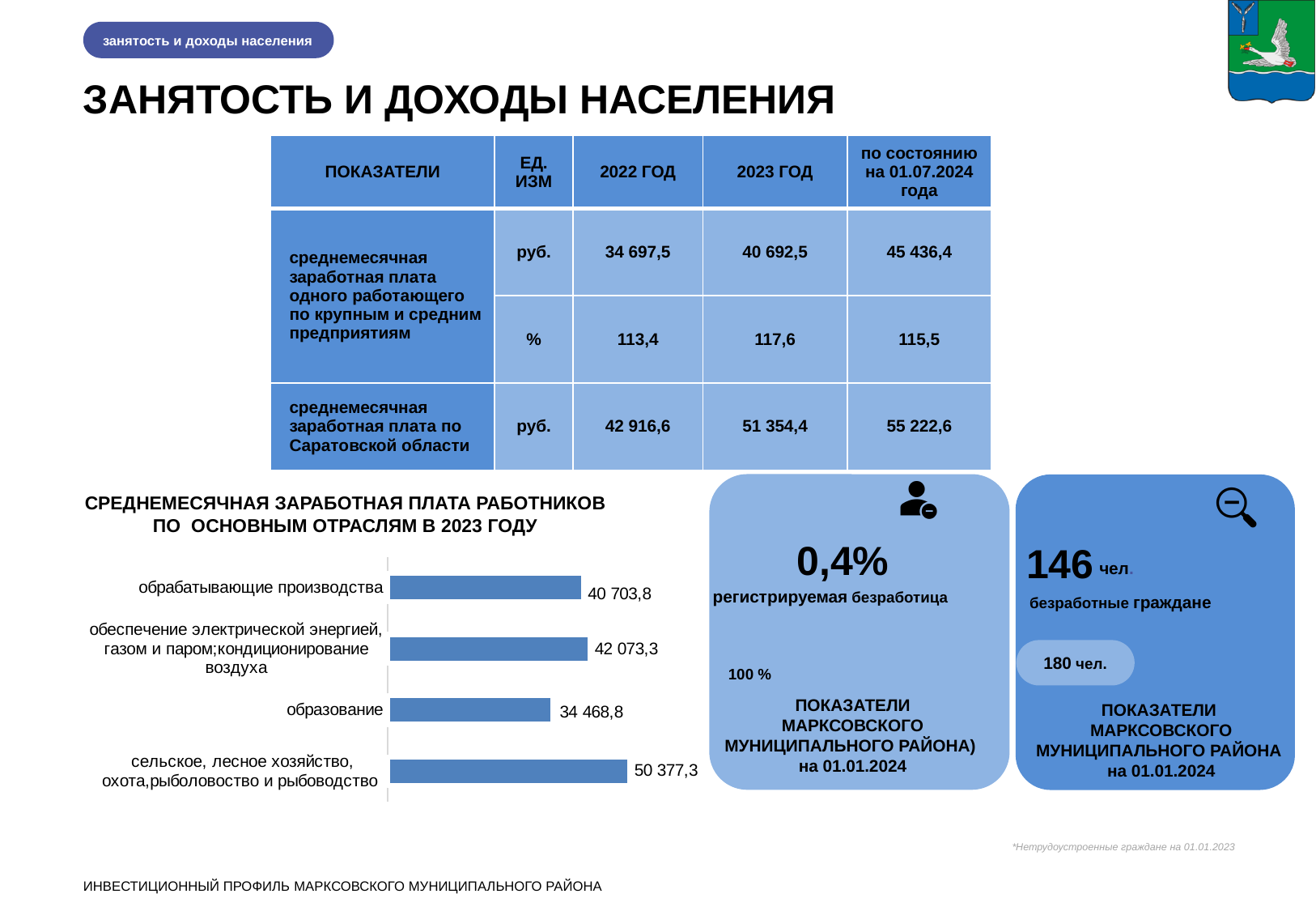
Which is larger in the bar chart: the value for обрабатывающие производства or for образование? обрабатывающие производства Which industry has the lowest average monthly wage in the bar chart? образование How many industries are shown in the bar chart? 4 What is the value for обеспечение электрической энергией, газом и паром; кондиционирование воздуха in the bar chart? 42 073,3 What is the value for обрабатывающие производства in the bar chart? 40 703,8 What is the difference between the values for сельское, лесное хозяйство and образование in the bar chart? 15 908,5 What is the value for образование in the chart 'Среднемесячная заработная плата работников по основным отраслям в 2023 году'? 34 468,8 What is the title of the bar chart on the slide? СРЕДНЕМЕСЯЧНАЯ ЗАРАБОТНАЯ ПЛАТА РАБОТНИКОВ ПО ОСНОВНЫМ ОТРАСЛЯМ В 2023 ГОДУ What type of chart is used to show average monthly wages by industry in 2023? bar chart What is the difference between the values for обеспечение электрической энергией and обрабатывающие производства in the bar chart? 1 369,5 What is the value for сельское, лесное хозяйство, охота, рыболовство и рыбоводство in the bar chart? 50 377,3 Which industry has the highest average monthly wage in the bar chart? сельское, лесное хозяйство, охота, рыболовство и рыбоводство